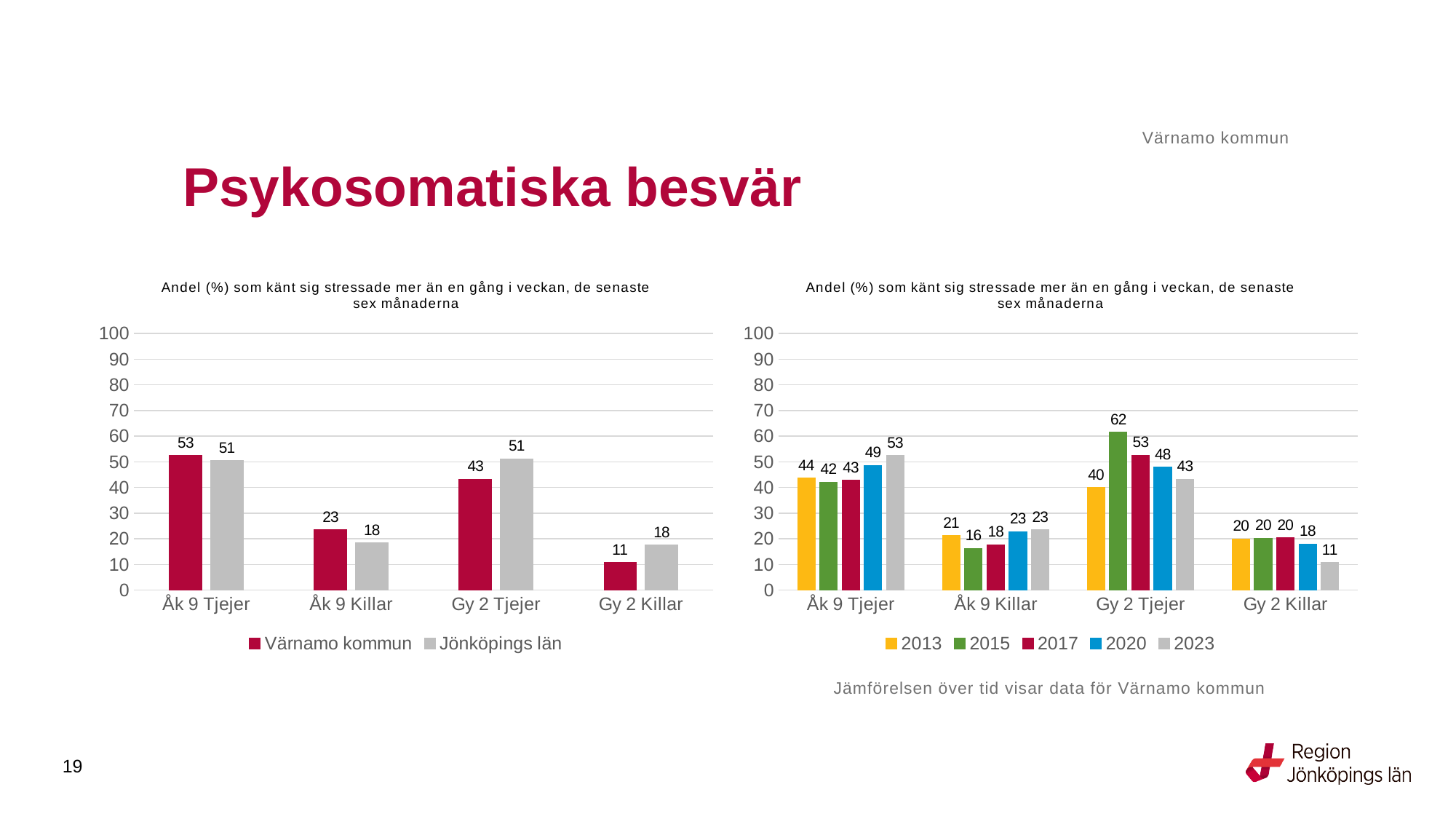
In the left chart, what is the difference between Jönköpings län and Värnamo kommun for Gy 2 Tjejer? 8 In the left chart, what is the value for Värnamo kommun for Åk 9 Tjejer? 53 How many series does the legend of the left chart list? 2 In the left chart, what is the value for Jönköpings län for Gy 2 Killar? 18 In the right chart, what is the value for 2015 for Gy 2 Tjejer? 62 In the left chart, which category has the lowest value for Värnamo kommun? Gy 2 Killar What kind of chart is the right chart? Bar chart In the right chart, what is the value for 2023 for Åk 9 Tjejer? 53 In the left chart, which is larger for Åk 9 Killar: Värnamo kommun or Jönköpings län? Värnamo kommun How many series does the legend of the right chart list? 5 In the right chart, what is the difference between 2023 and 2013 for Åk 9 Tjejer? 9 In the right chart, which year has the highest value for Gy 2 Tjejer? 2015